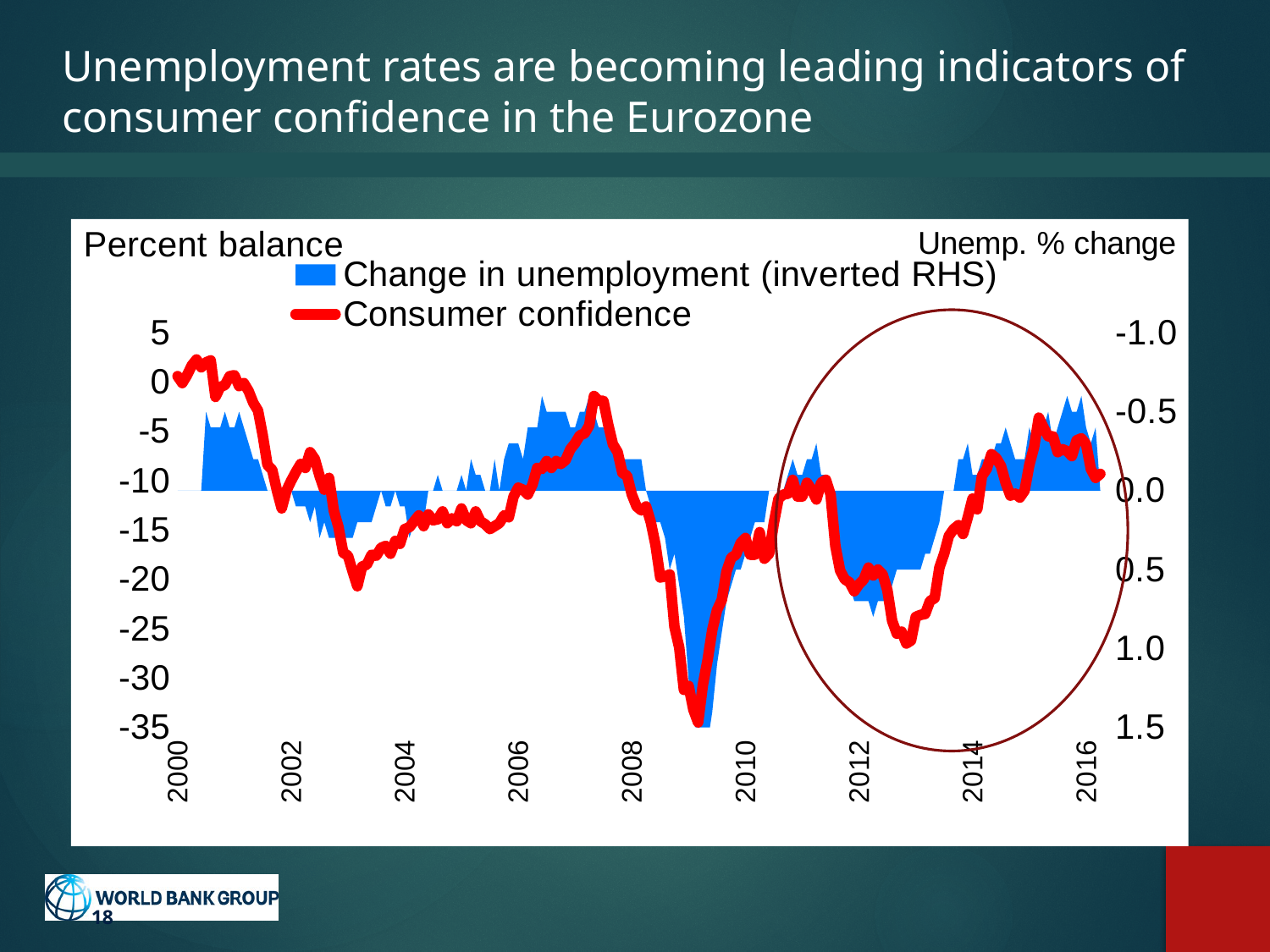
Is the Consumer confidence value at its 2007 peak greater or less than -5? greater Is the lowest value of Consumer confidence, around 2009, greater or less than -30? less Is the Consumer confidence value at the start of 2003 greater or less than -15? less Does Consumer confidence rise or fall between 2007 and 2009? fall What are the two series named in the chart legend? Change in unemployment (inverted RHS) and Consumer confidence Which colour is used for the Consumer confidence series? Red What kind of chart is shown on the slide? A combined area and line chart How many series does the chart legend list? 2 Does Consumer confidence rise or fall between 2013 and 2015? rise In which year does the Consumer confidence line reach its lowest point? 2009 How many year labels are shown on the x axis? 9